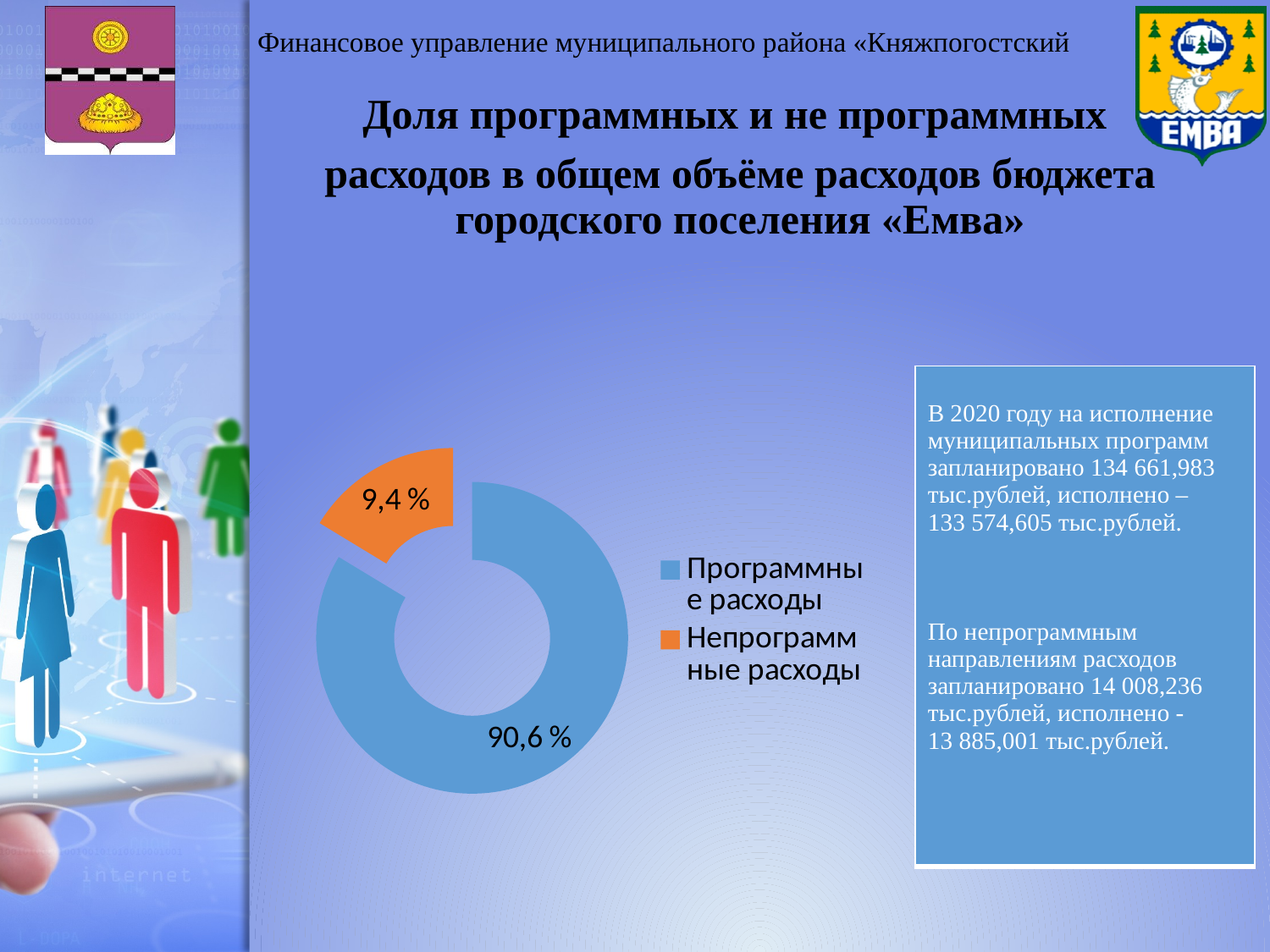
How many entries does the chart legend list? 2 What share of budget expenditures is shown for «Непрограммные расходы»? 9,4 % Which category has the smallest share in the chart? Непрограммные расходы How many categories (slices) does the chart contain? 2 What colour represents «Программные расходы» in the chart? blue Which category has the largest share in the chart? Программные расходы What kind of chart is shown on the slide? doughnut chart By how many percentage points does the share of «Программные расходы» exceed the share of «Непрограммные расходы»? 81,2 % What colour represents «Непрограммные расходы» in the chart? orange What share of budget expenditures is shown for «Программные расходы»? 90,6 % Which is larger: the share of «Программные расходы» or the share of «Непрограммные расходы»? Программные расходы What is the combined share of the two slices in the chart? 100 %